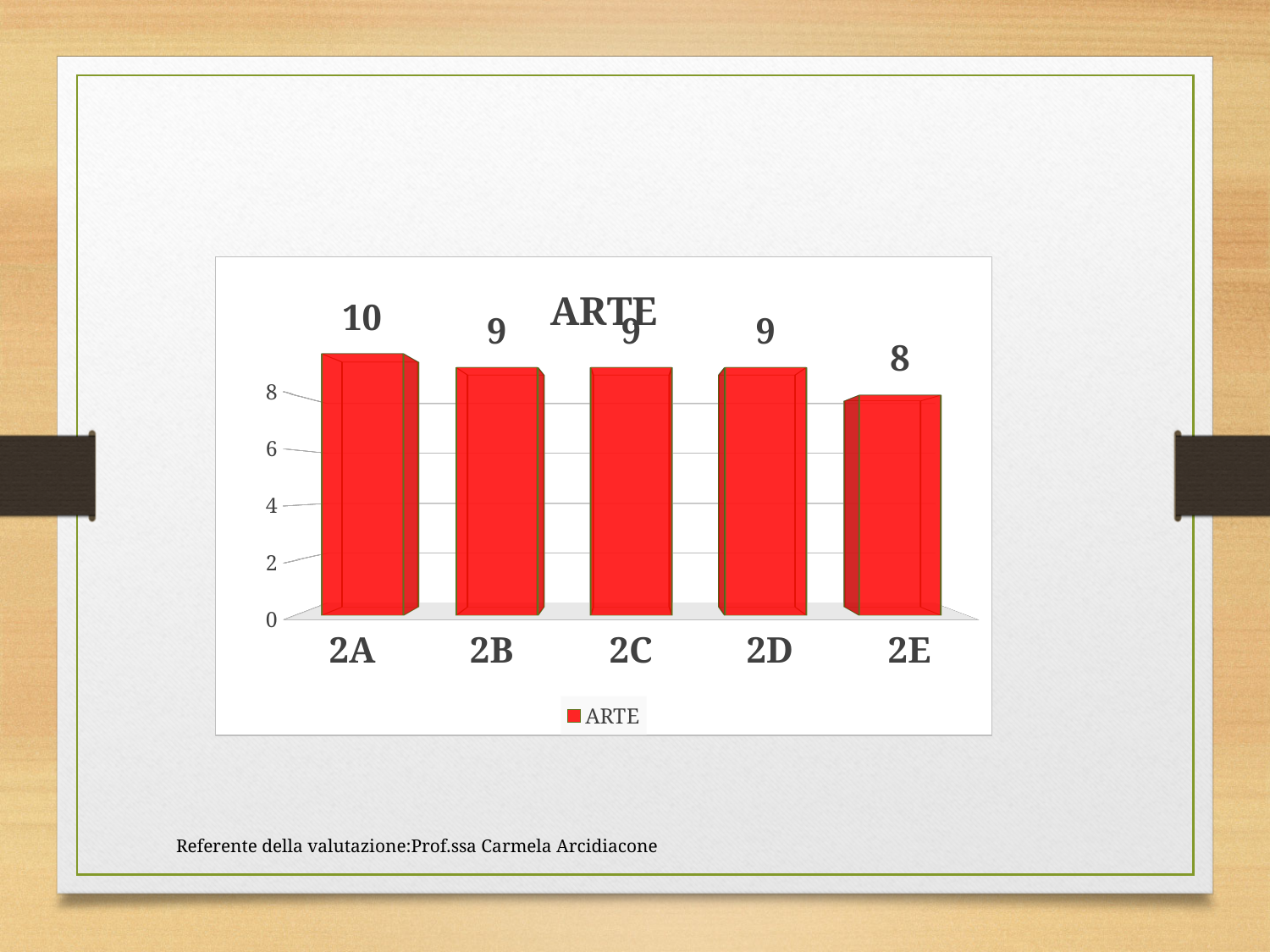
What is the value for 2C? 9 How many categories are shown on the x axis? 5 What is the title of the chart? ARTE Which is larger, the value for 2B or the value for 2E? 2B What is the value for 2E? 8 What is the difference between the values for 2A and 2E? 2 What colour are the bars? red What is the value for 2A? 10 Which category has the highest value? 2A Which category has the lowest value? 2E How many series does the legend list? 1 What kind of chart is shown? bar chart